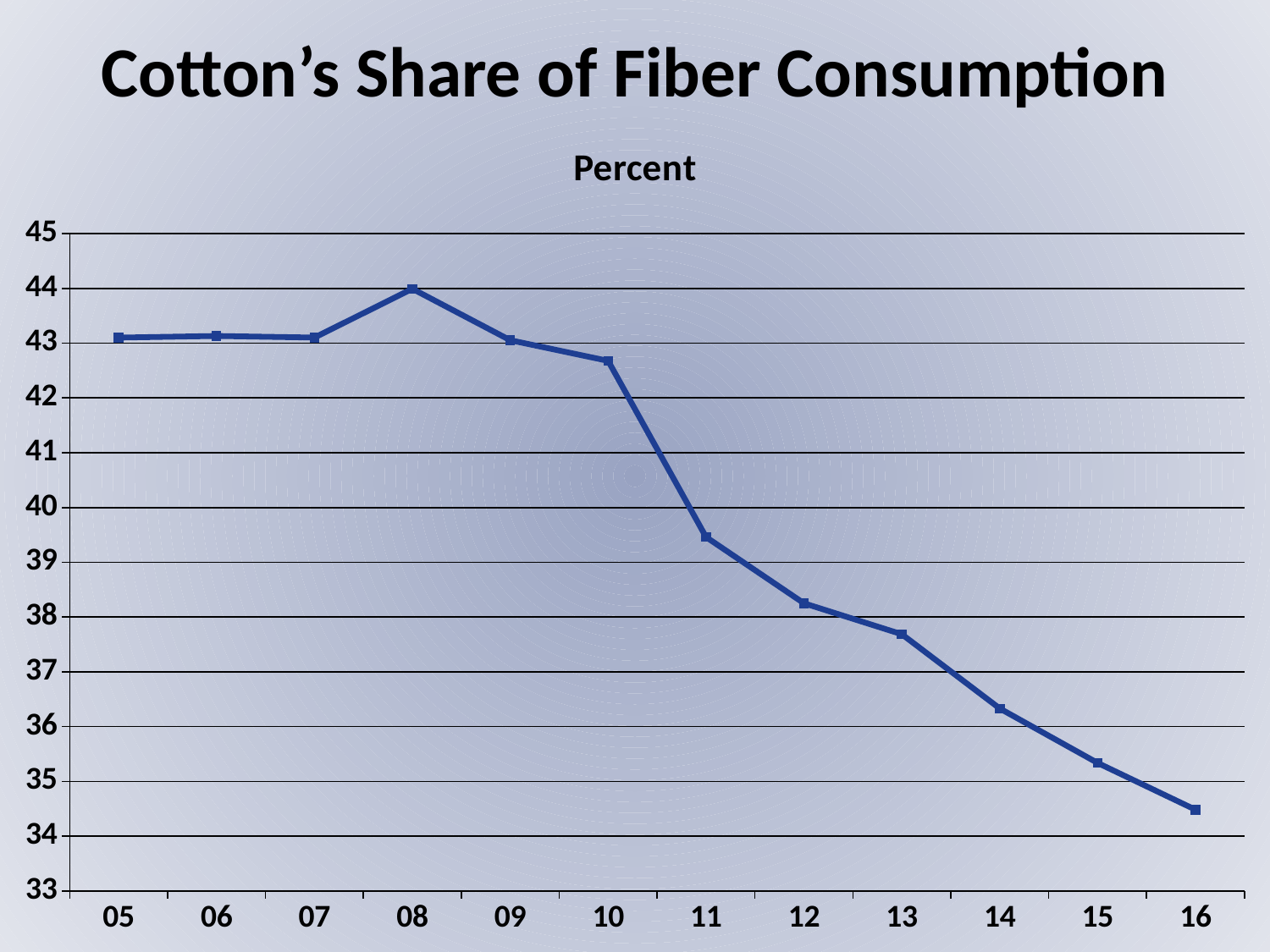
What is the title of the chart? Percent Is the value for 10 greater or less than 42? greater Overall, do the values rise or fall from 05 to 16? Fall Which year has the larger value, 13 or 15? 13 Is the value for 16 greater or less than 35? less Is the value for 14 greater or less than 36? greater What kind of chart is shown on the slide? Line chart In which year is cotton's share of fiber consumption highest? 08 In which year is cotton's share of fiber consumption lowest? 16 Which year has the larger value, 08 or 12? 08 How many data points are plotted on the line? 12